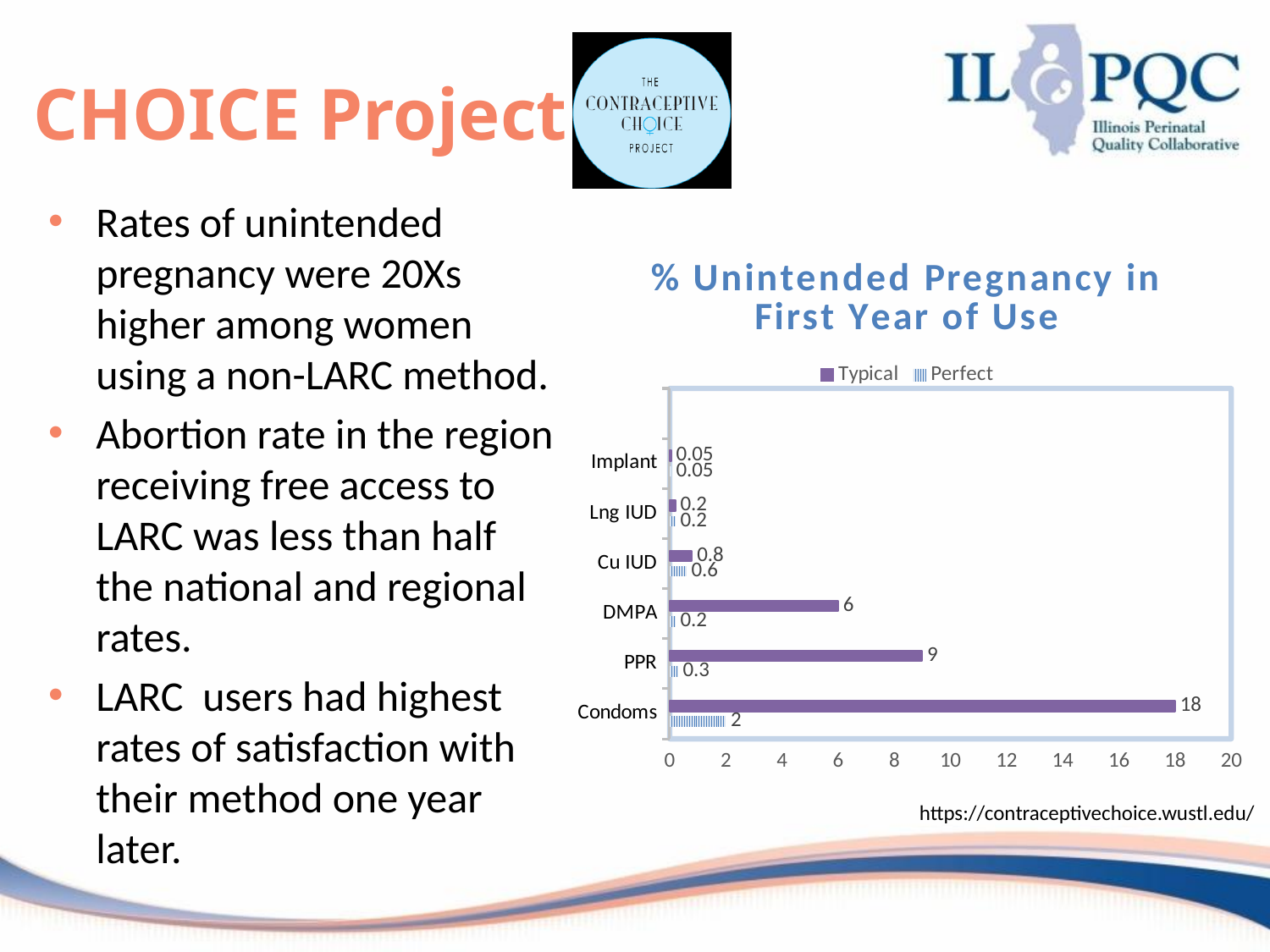
What is the Typical value for Cu IUD? 0.8 What are the two series named in the legend? Typical and Perfect Which category has the highest Typical value? Condoms What is the title of the chart? % Unintended Pregnancy in First Year of Use What is the Perfect value for DMPA? 0.2 What is the difference between the Typical and Perfect values for PPR? 8.7 How many series does the legend list? 2 Which category has the lowest Perfect value? Implant What kind of chart is shown on the slide? Bar chart How many categories are shown on the chart? 6 What is the Typical value for Condoms? 18 Which is larger, the Typical value for DMPA or the Typical value for PPR? PPR